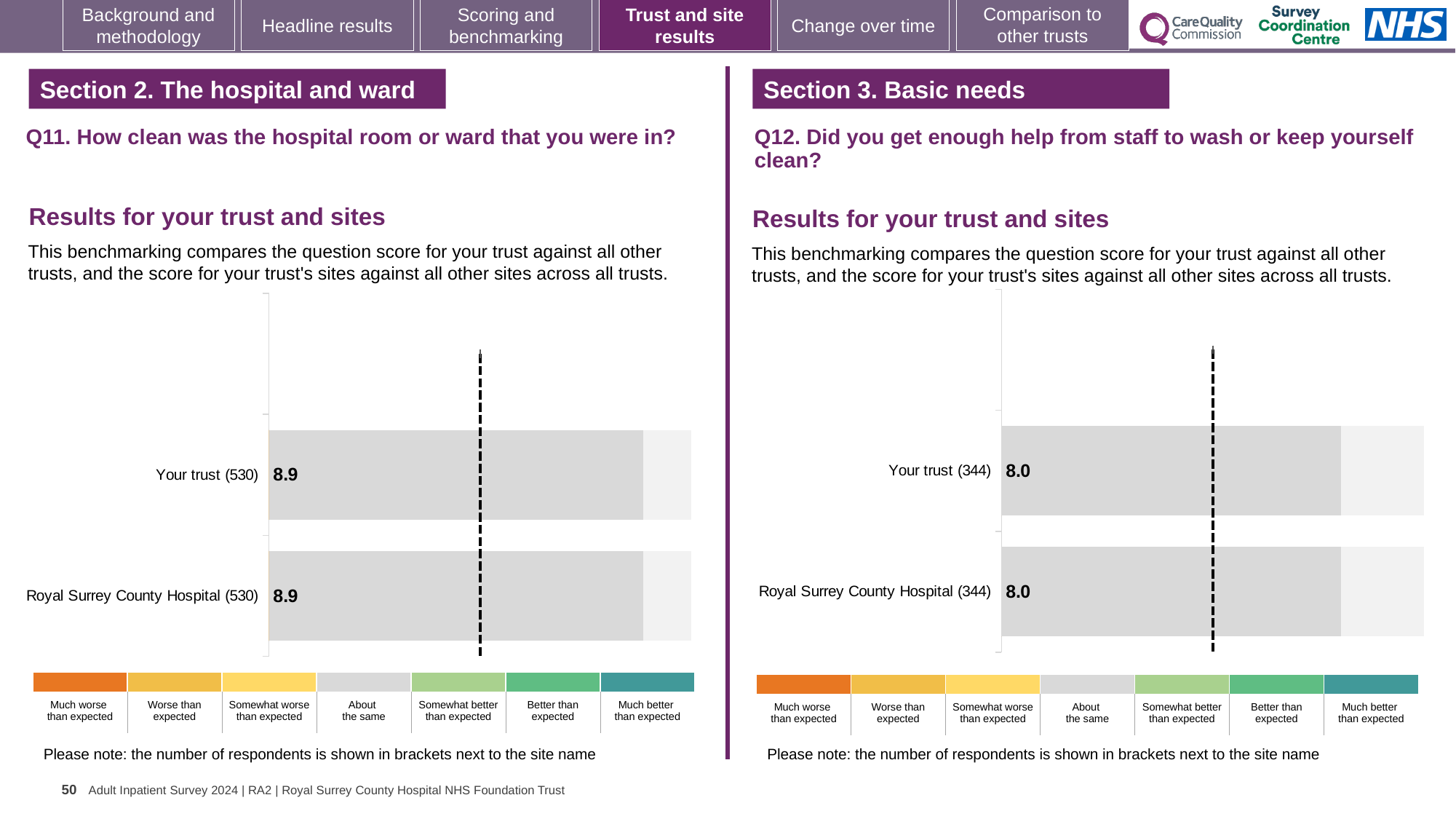
How many bars are plotted on the Q11 chart (left)? 2 On the Q12 chart (right), what is the score for Royal Surrey County Hospital? 8.0 What kind of chart is used for the Q12 results (right)? Bar chart On the Q11 chart (left), what is the score for Royal Surrey County Hospital? 8.9 On the Q12 chart (right), how many respondents are shown in brackets for Royal Surrey County Hospital? 344 On the Q12 chart (right), what is the score for Your trust? 8.0 On the Q11 chart (left), what is the score for Your trust? 8.9 How many categories does the colour key below the Q11 chart (left) list? 7 On the Q11 chart (left), how many respondents are shown in brackets for Your trust? 530 On the Q11 chart (left), what is the difference between the score for Your trust and the score for Royal Surrey County Hospital? 0.0 On the Q12 chart (right), what is the difference between the score for Your trust and the score for Royal Surrey County Hospital? 0.0 Which is larger: the Your trust score on the Q11 chart (left) or the Your trust score on the Q12 chart (right)? Q11 chart (8.9)